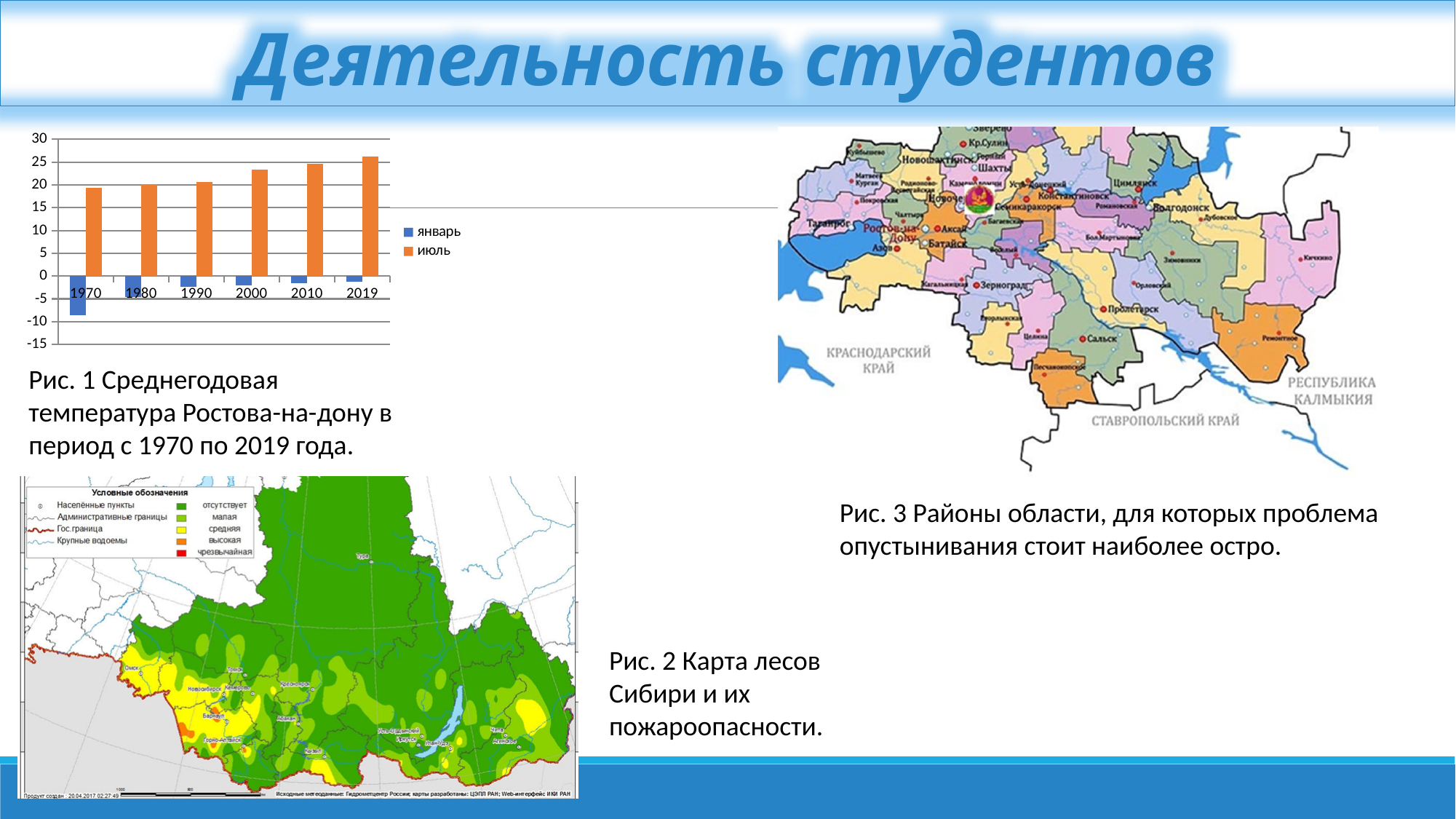
In the bar chart (Рис. 1), is the июль value for 2019 greater or less than 25? greater In the bar chart (Рис. 1), which is larger: the июль value for 2019 or the июль value for 1970? 2019 How many series does the legend of the bar chart (Рис. 1) list? 2 In the bar chart (Рис. 1), is the январь value for 1970 greater or less than -5? less In the bar chart (Рис. 1), do the июль values rise or fall from 1970 to 2019? rise In the bar chart (Рис. 1), is the июль value for 1970 greater or less than 20? less What kind of chart is shown in Рис. 1 on the slide? bar chart How many years are shown on the x axis of the bar chart (Рис. 1)? 6 In the bar chart (Рис. 1), what colour are the bars for the июль series? orange In the bar chart (Рис. 1), which year has the highest value for июль? 2019 Which two series are listed in the legend of the bar chart (Рис. 1)? январь and июль In the bar chart (Рис. 1), which year has the lowest value for январь? 1970